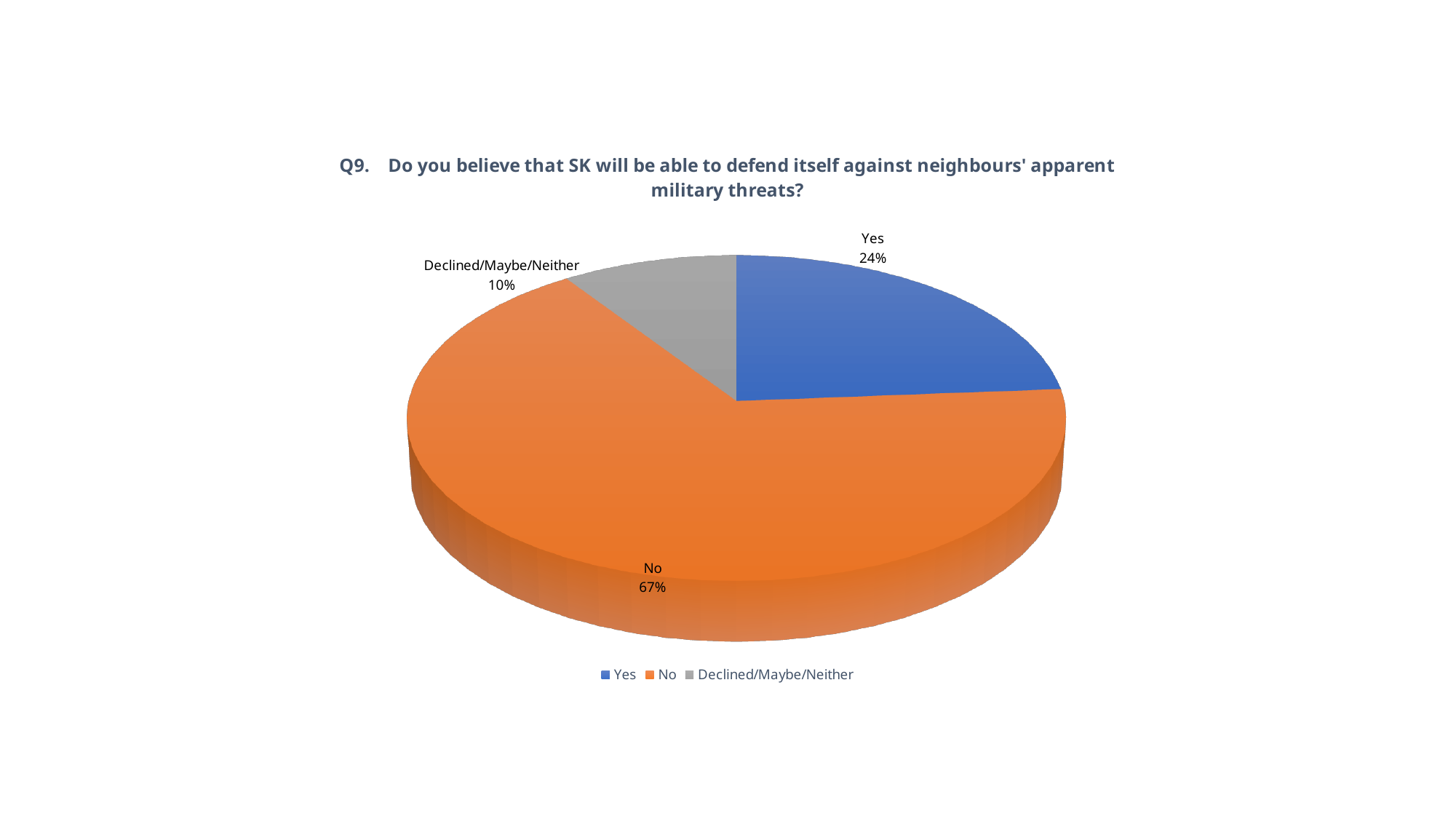
What percentage of respondents answered "No"? 67% What kind of chart is shown on the slide? Pie chart What percentage of respondents fall under "Declined/Maybe/Neither"? 10% How many entries does the legend list? 3 What is the difference in percentage points between the "No" and "Yes" slices? 43 Which response has the smallest share of the pie? Declined/Maybe/Neither What is the title of the chart? Q9. Do you believe that SK will be able to defend itself against neighbours' apparent military threats? How many slices does the pie chart have? 3 What percentage of respondents answered "Yes"? 24% Which is larger, the "Yes" slice or the "Declined/Maybe/Neither" slice? Yes What colour is the "No" slice? Orange Which response has the largest share of the pie? No